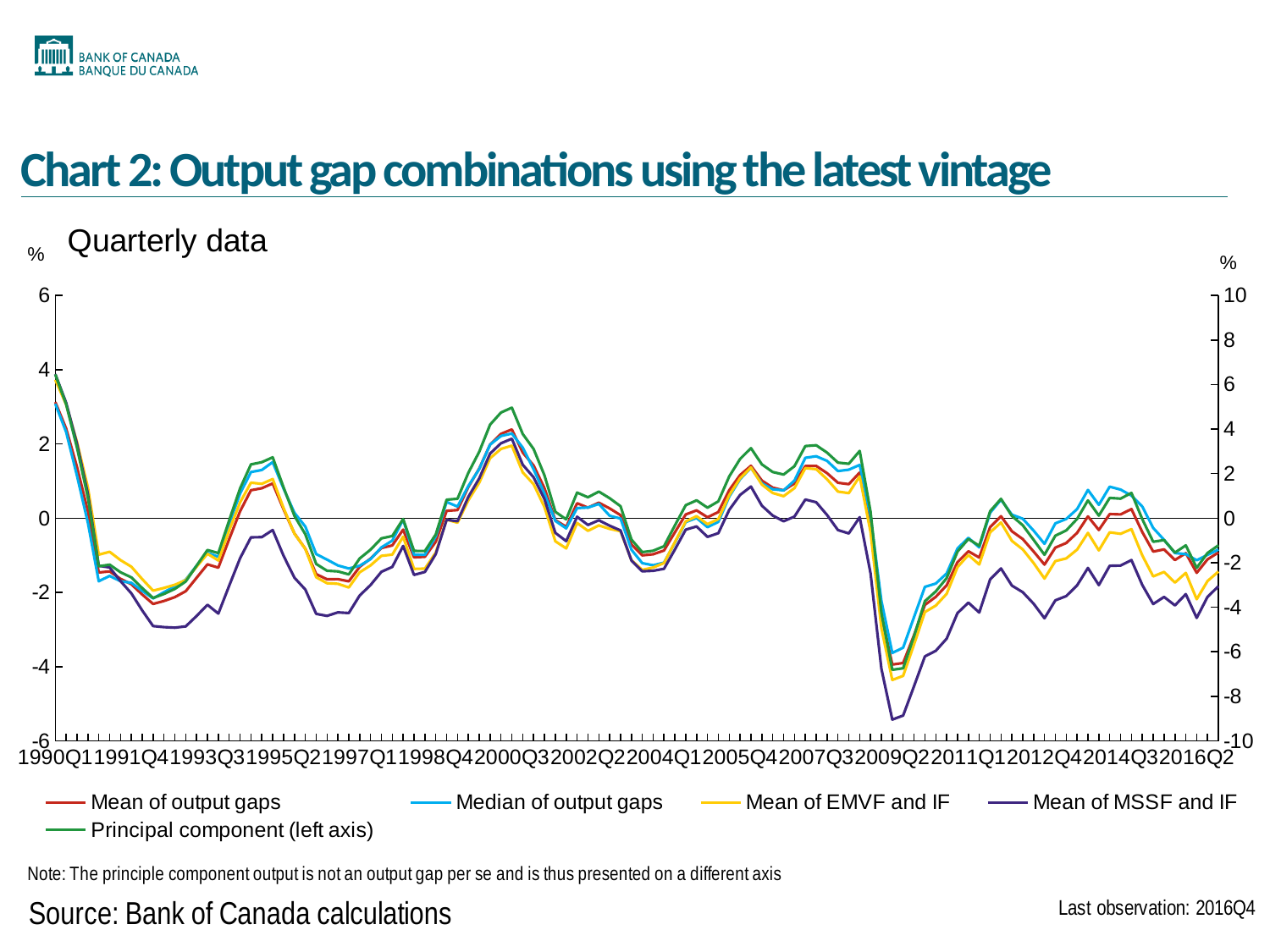
Which series reaches the lowest point around 2009Q2? Mean of MSSF and IF Which series does the legend say is plotted on the left axis? Principal component What is the last observation date given for the chart? 2016Q4 What is the title of the chart? Chart 2: Output gap combinations using the latest vintage What is the highest value shown on the right-hand axis? 10 Do the series rise or fall between 1990Q1 and 1991Q4? fall How many series does the legend list? 5 Is the value for Principal component at 1990Q1 greater or less than 0? greater How many date labels are shown on the x axis? 16 Do the series rise or fall between 2009Q2 and 2011Q1? rise What kind of chart is shown on the slide? Line chart Is the value for Mean of MSSF and IF at its lowest point around 2009Q2 greater or less than 0? less